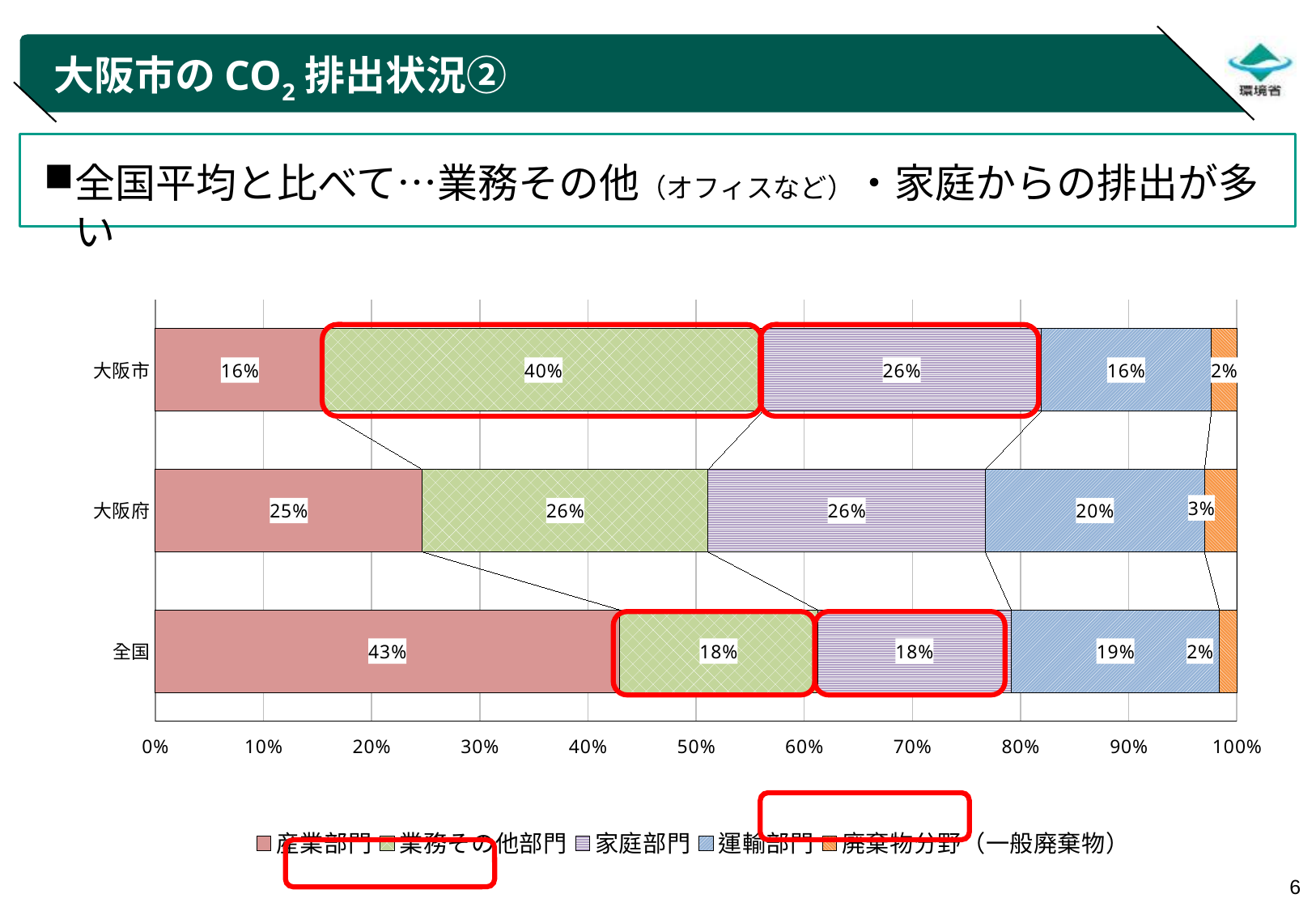
Which is larger: the 業務その他部門 value for 大阪市 or for 大阪府? 大阪市 Which series is represented by the orange segments at the right end of each bar? 廃棄物分野（一般廃棄物） What is the value of 業務その他部門 for 大阪市? 40% Which category has the highest value for 産業部門? 全国 What type of chart is shown on the slide? Stacked bar chart What is the difference between the 家庭部門 value for 大阪市 and for 全国? 8% How many categories (rows) are plotted in the chart? 3 How many series does the legend list? 5 What is the value of 廃棄物分野（一般廃棄物） for 大阪府? 3% Which category has the lowest value for 業務その他部門? 全国 What is the value of 産業部門 for 全国? 43% What is the value of 運輸部門 for 大阪府? 20%